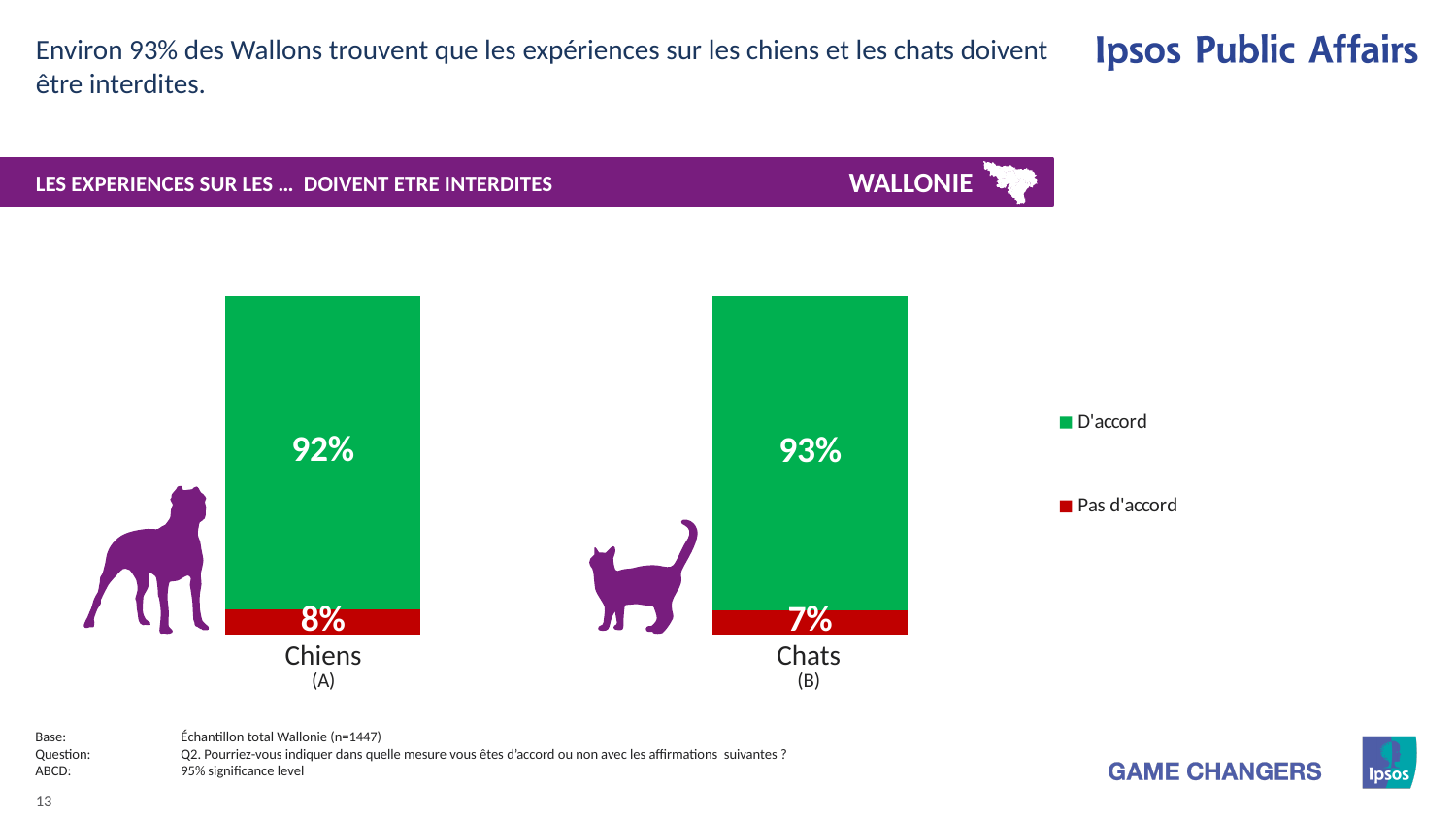
How many series does the legend list? 2 Which category has the higher "D'accord" value? Chats What kind of chart is shown on the slide? Stacked bar chart What is the difference between the "D'accord" values for Chats and Chiens? 1% What is the "Pas d'accord" value for Chats? 7% Is the "Pas d'accord" value for Chiens larger or smaller than the "Pas d'accord" value for Chats? larger Which category has the lower "Pas d'accord" value? Chats What is the "D'accord" value for Chats? 93% What is the "D'accord" value for Chiens? 92% What is the total of the stacked bar for Chiens? 100% What is the "Pas d'accord" value for Chiens? 8% How many categories are shown on the x axis? 2